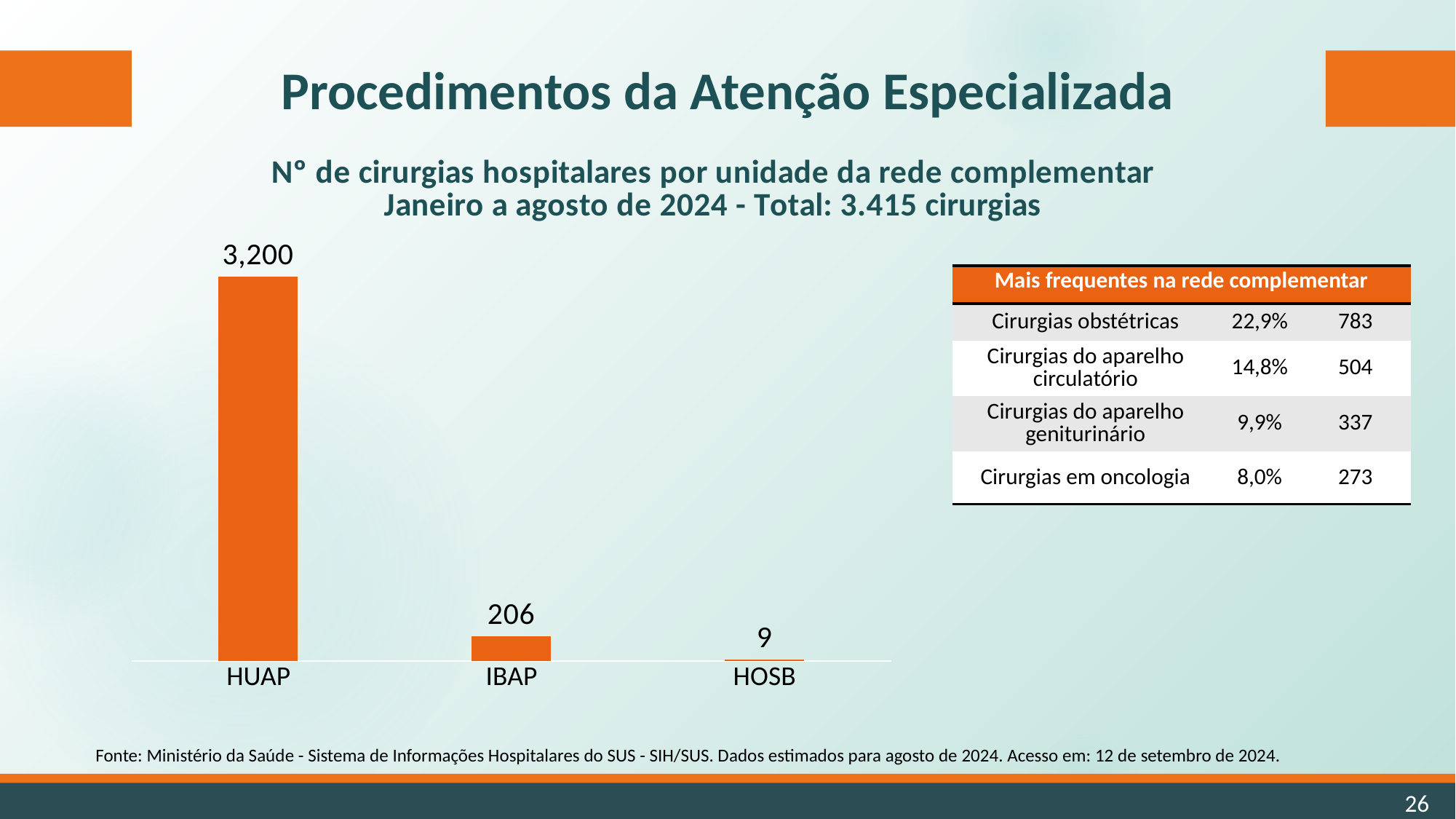
What is the difference between the number of surgeries at HUAP and IBAP? 2,994 What total number of surgeries is stated in the chart title? 3.415 cirurgias Do the values rise or fall from left to right across the units? Fall What is the difference between the number of surgeries at IBAP and HOSB? 197 What is the number of surgeries for IBAP? 206 What is the number of surgeries for HOSB? 9 What kind of chart is shown on the slide? Bar chart How many units are shown in the chart? 3 Which unit has the lowest number of surgeries? HOSB Which has more surgeries, IBAP or HOSB? IBAP What is the number of surgeries for HUAP? 3,200 Which unit has the highest number of surgeries? HUAP